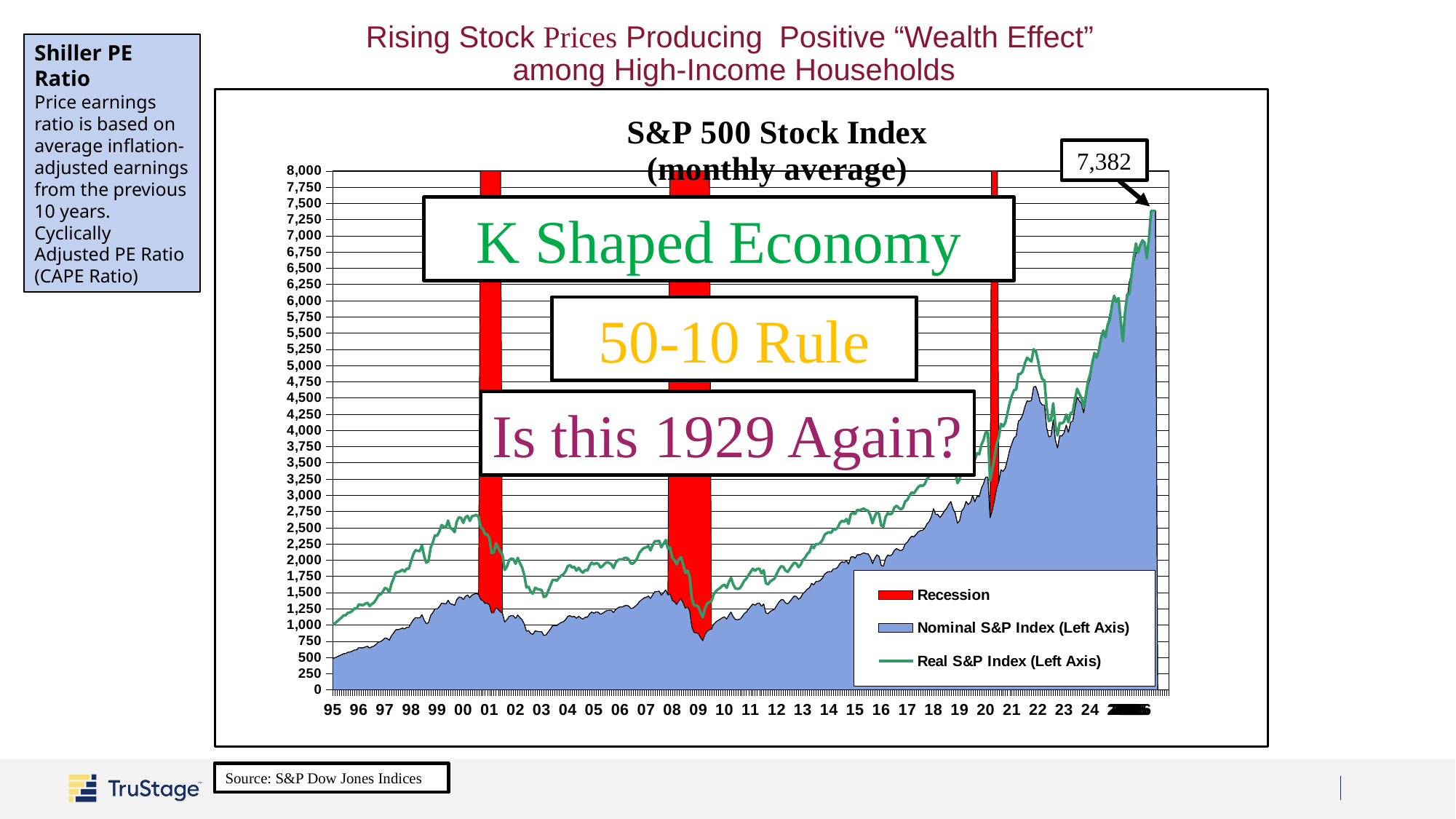
Around 00, which is higher: the Real S&P Index or the Nominal S&P Index? Real S&P Index Does the Nominal S&P Index generally rise or fall from 95 to 24? rise Is the Nominal S&P Index at its 2009 low greater or less than 1,000? less What colour are the recession bars in the chart? red Is the Nominal S&P Index at its dip in 20 greater or less than 3,000? less How many series does the chart's legend list? 3 Is the Nominal S&P Index at the start of the chart in 95 greater or less than 750? less How many recession bars are shaded on the chart? 3 What value is printed in the callout at the right end of the S&P 500 index line? 7,382 What is the title of the chart? S&P 500 Stock Index (monthly average)